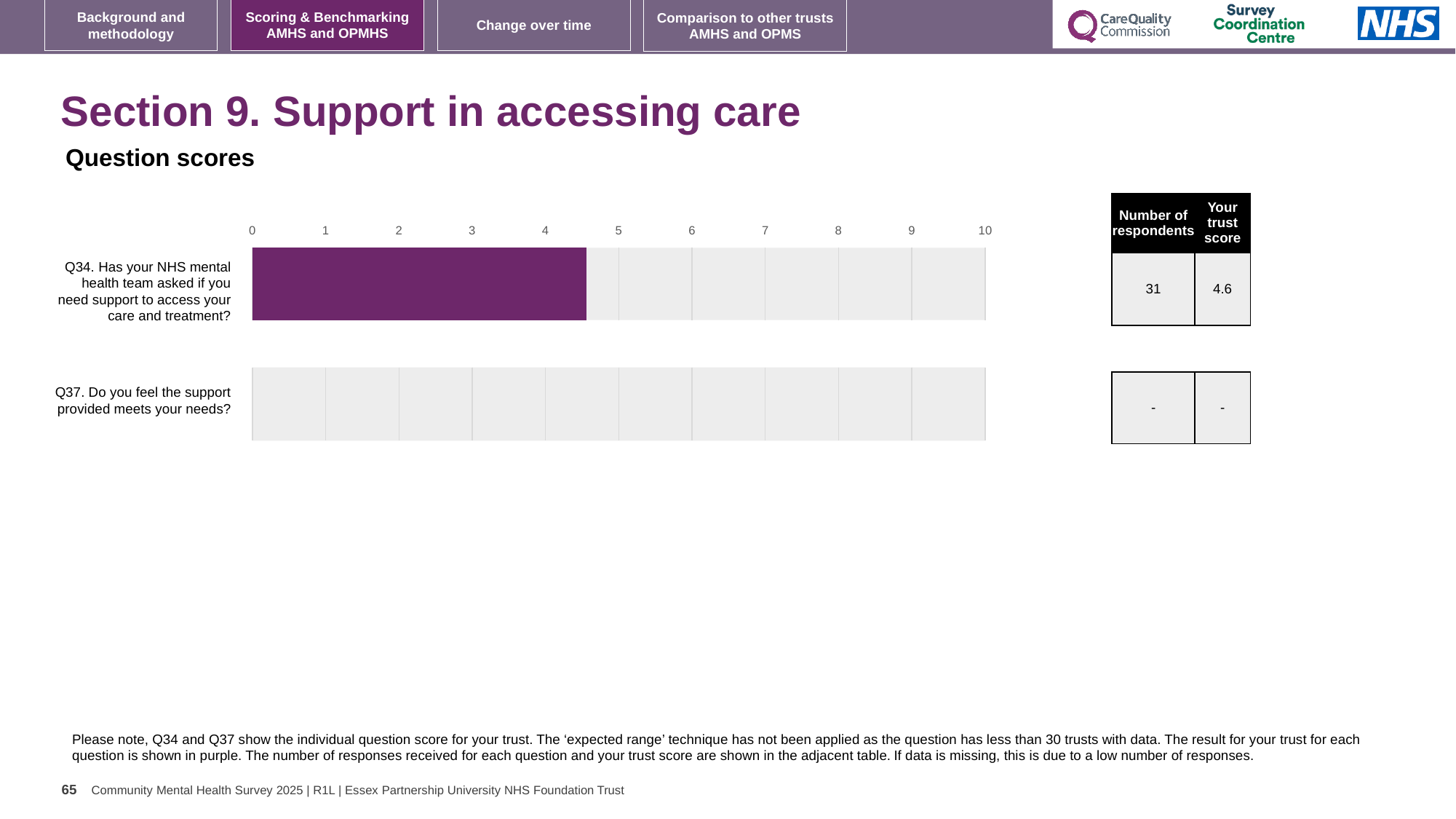
What colour is the bar for Q34? purple What kind of chart is used to show the question scores? bar chart What is the maximum value shown on the chart's horizontal axis? 10 Is the value for Q34 greater or less than 5? less What is the trust score for Q34 shown in the table next to the chart? 4.6 How many respondents answered Q34 according to the table? 31 What is shown in the table for the trust score of Q37? - Which question has a plotted bar on the chart, Q34 or Q37? Q34 How many questions are listed on the chart? 2 Is the value for Q34 greater or less than 4? greater